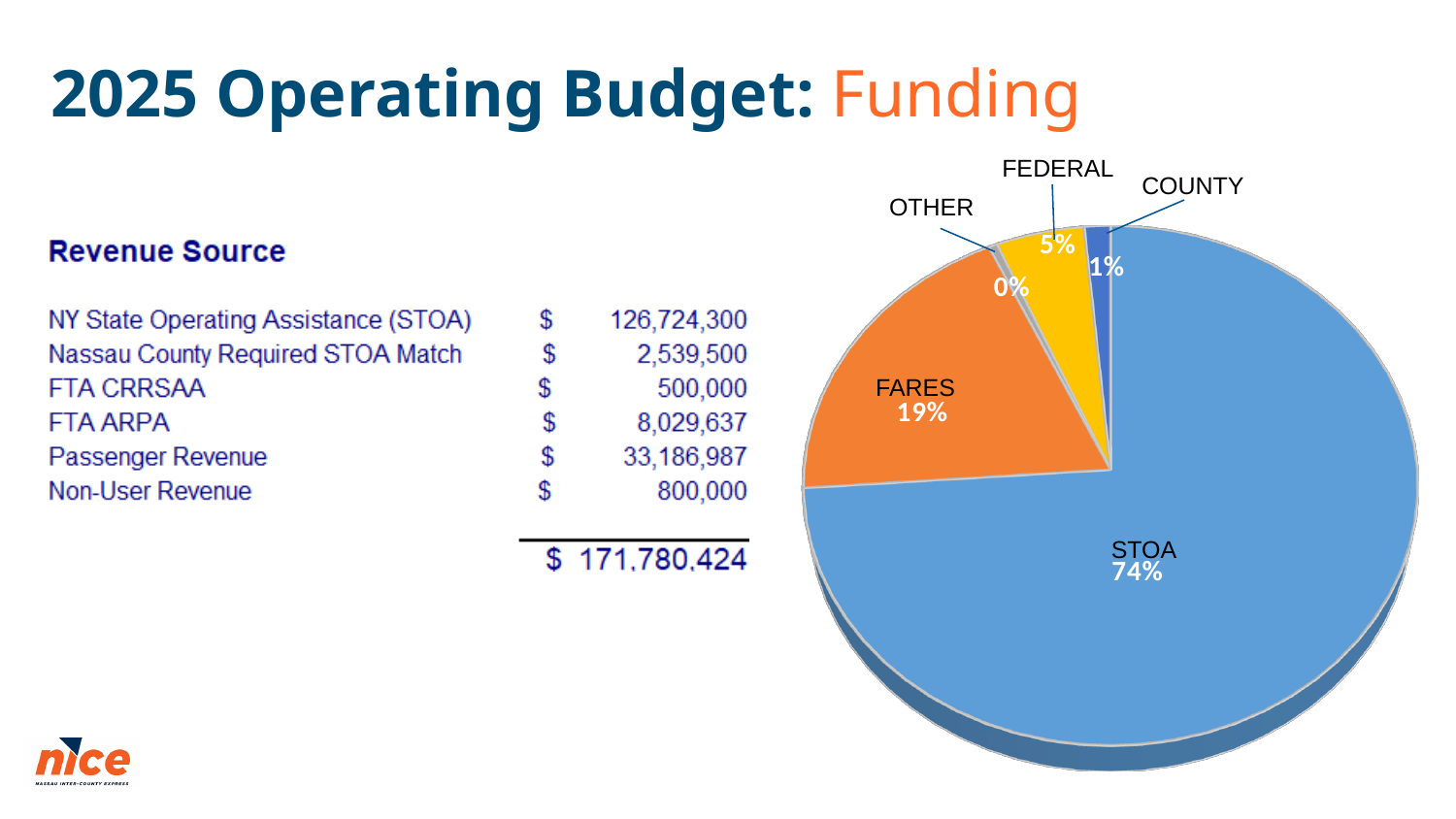
What share of the pie does FARES represent? 19% Which slice of the pie chart is the largest? STOA What is the difference in percentage points between the STOA and FARES slices? 55 What share of the pie does STOA represent? 74% Which slice of the pie chart is the smallest? OTHER What kind of chart is shown on the slide? pie chart How many slices are labelled in the pie chart? 5 Which is larger in the pie chart, FEDERAL or COUNTY? FEDERAL What share of the pie does COUNTY represent? 1% What colour is the STOA slice in the pie chart? blue